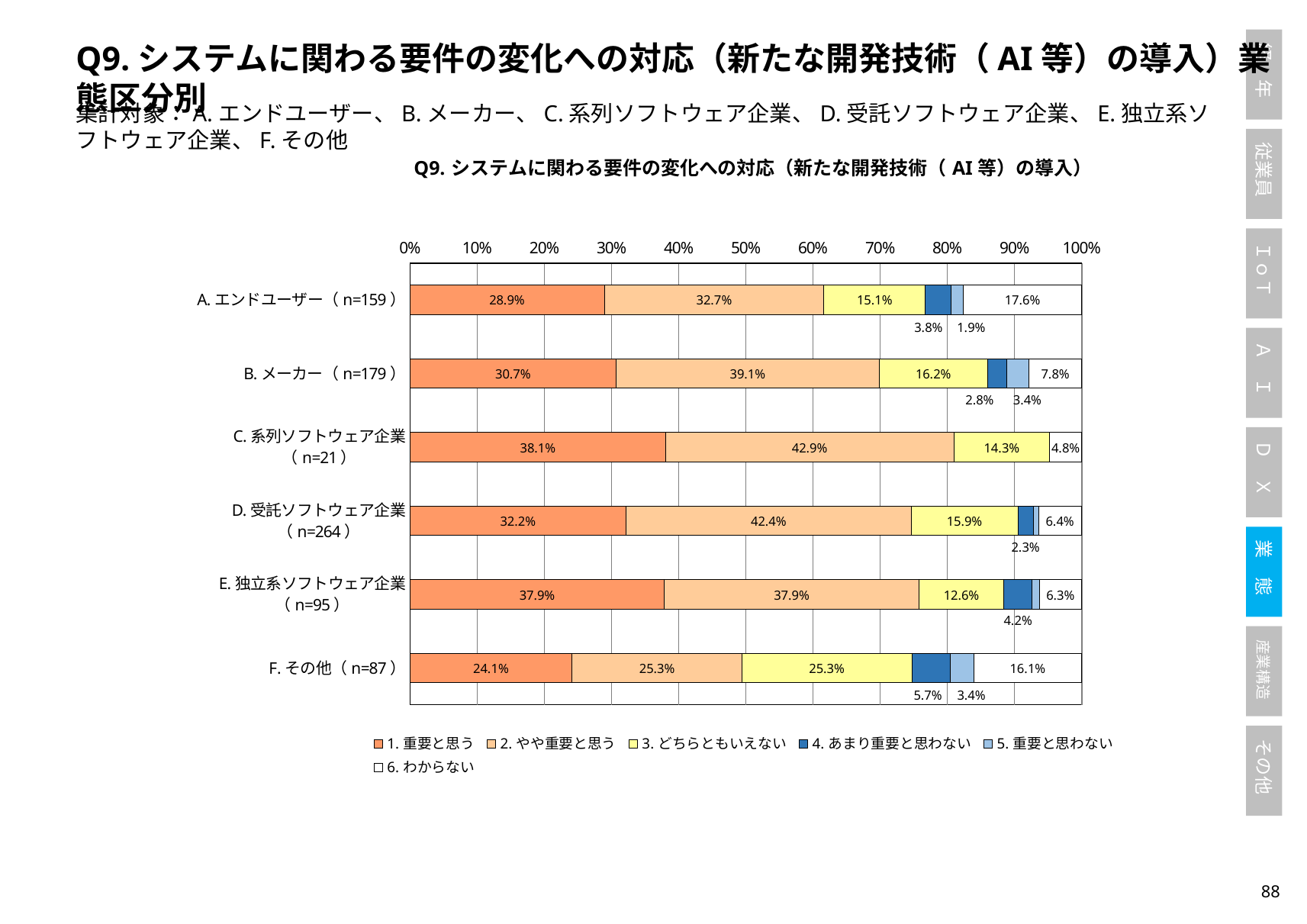
What is the sample size (n) shown for D. 受託ソフトウェア企業? 264 Which is larger for 「2. やや重要と思う」: B. メーカー or D. 受託ソフトウェア企業? D. 受託ソフトウェア企業 Which category has the highest value for 「3. どちらともいえない」? F. その他 Which category has the lowest value for 「1. 重要と思う」? F. その他 How many business categories (bars) are plotted in the chart? 6 What is the value of 「2. やや重要と思う」 for D. 受託ソフトウェア企業? 42.4% What kind of chart is shown on the slide? Horizontal stacked bar chart How many series does the legend list? 6 What is the value of 「4. あまり重要と思わない」 for F. その他? 5.7% What is the value of 「6. わからない」 for A. エンドユーザー? 17.6% For A. エンドユーザー, what is the difference between 「2. やや重要と思う」 and 「1. 重要と思う」? 3.8 percentage points What is the value of 「1. 重要と思う」 for C. 系列ソフトウェア企業? 38.1%